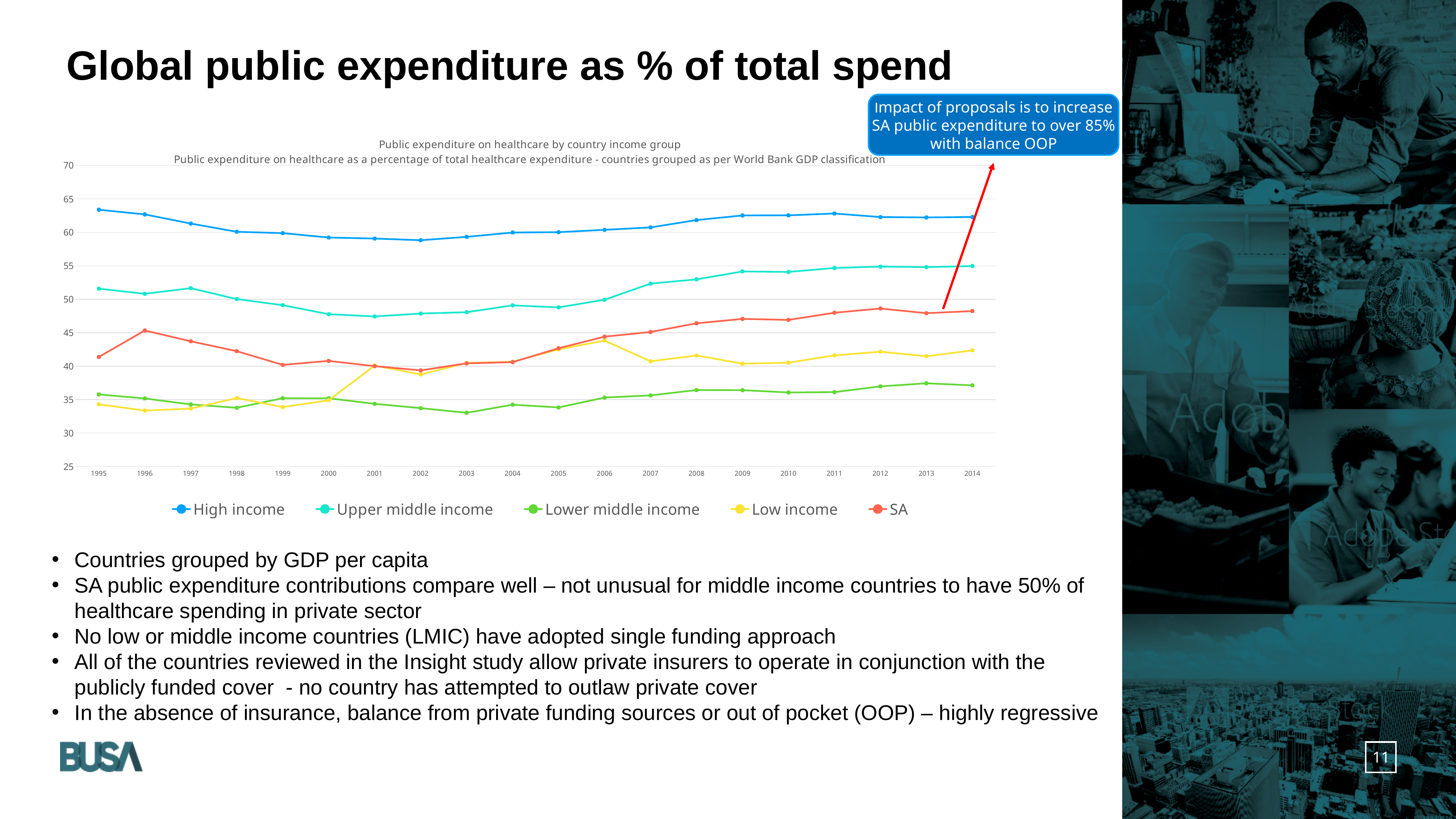
Is the value for High income in 1995 greater or less than 60? greater Is the value for Upper middle income in 2014 greater or less than 50? greater Is the value for Lower middle income in 2003 greater or less than 35? less How many years are plotted along the x axis? 20 Which series has the lowest value in 2014? Lower middle income In 2014, which is larger: the value for SA or the value for Low income? SA Which series is drawn in red? SA How many series does the legend list? 5 Does the Upper middle income line rise or fall between 2005 and 2014? Rises Which series has the highest value in 2014? High income What kind of chart is shown on the slide? Line chart